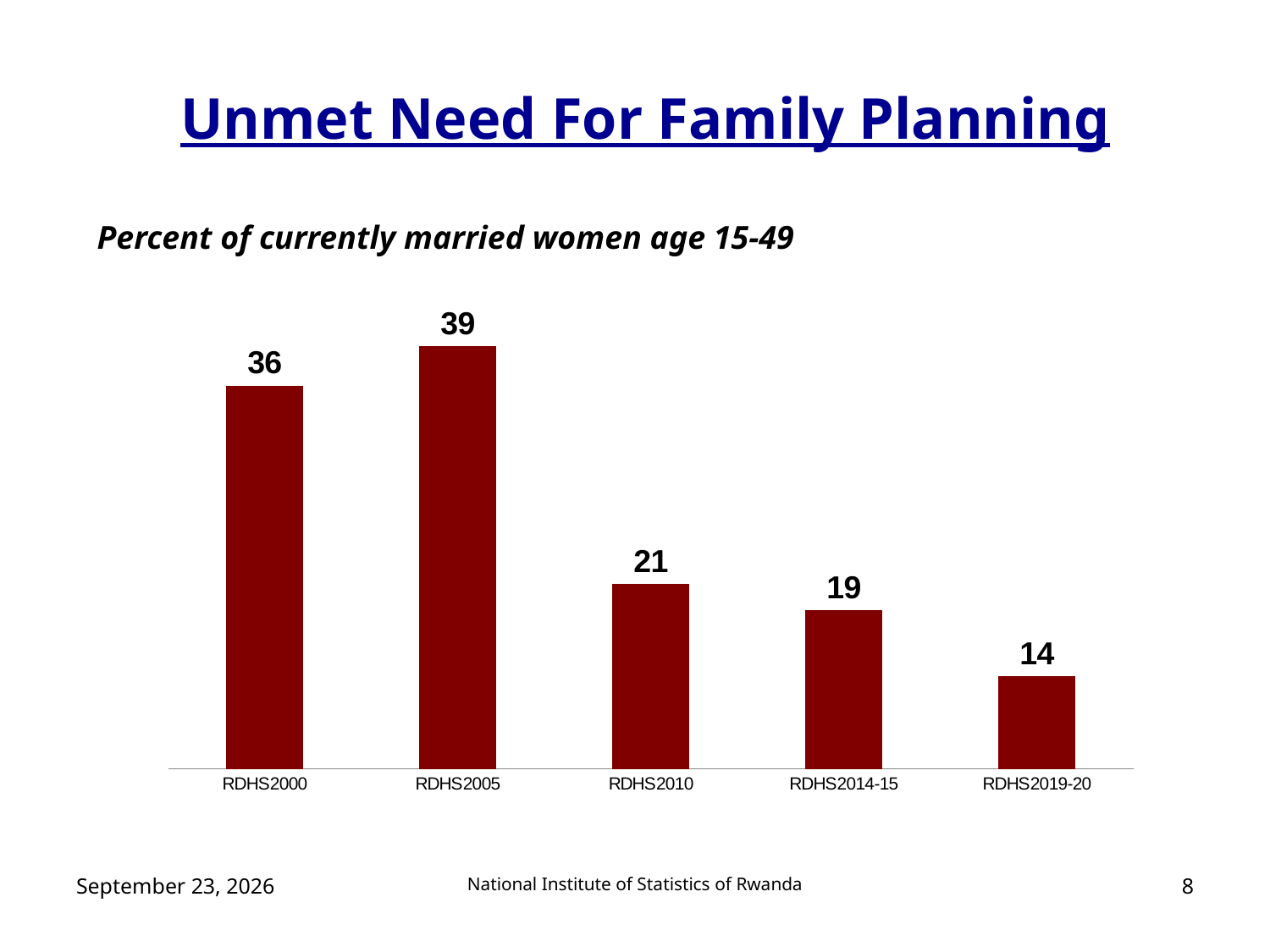
What is the value for RDHS2005? 39 What is the value for RDHS2010? 21 Which survey has the highest value? RDHS2005 Which is larger, the value for RDHS2000 or the value for RDHS2010? RDHS2000 What is the value for RDHS2019-20? 14 Which survey has the lowest value? RDHS2019-20 How many surveys are shown on the chart? 5 What kind of chart is shown on the slide? Bar chart What is the difference between the values for RDHS2010 and RDHS2014-15? 2 What is the title of the slide? Unmet Need For Family Planning What is the difference between the values for RDHS2005 and RDHS2019-20? 25 What is the value for RDHS2000? 36